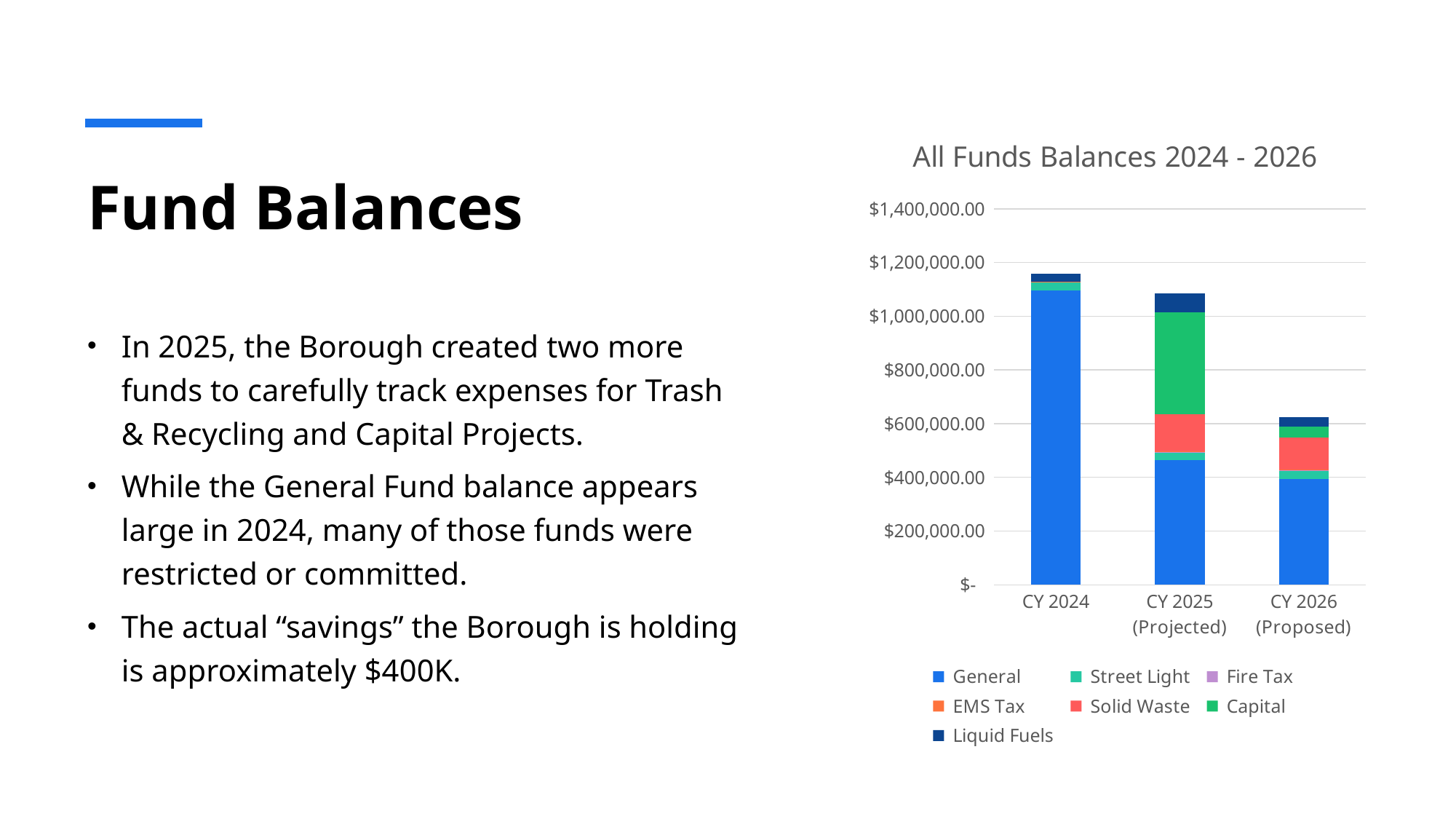
What kind of chart is shown on the slide? stacked bar chart Do the total fund balances rise or fall from CY 2024 to CY 2026? fall How many bars (years) are shown on the x axis? 3 Which year has the lowest total fund balance? CY 2026 (Proposed) Is the General fund balance for CY 2025 (Projected) greater or less than $600,000.00? less Is the total fund balance for CY 2026 (Proposed) greater or less than $800,000.00? less Which is larger, the total fund balance for CY 2024 or for CY 2026 (Proposed)? CY 2024 How many series does the chart legend list? 7 Which year has the highest total fund balance? CY 2024 What is the title of the chart? All Funds Balances 2024 - 2026 Is the total fund balance for CY 2024 greater or less than $1,000,000.00? greater In which year is the Capital fund segment the largest? CY 2025 (Projected)